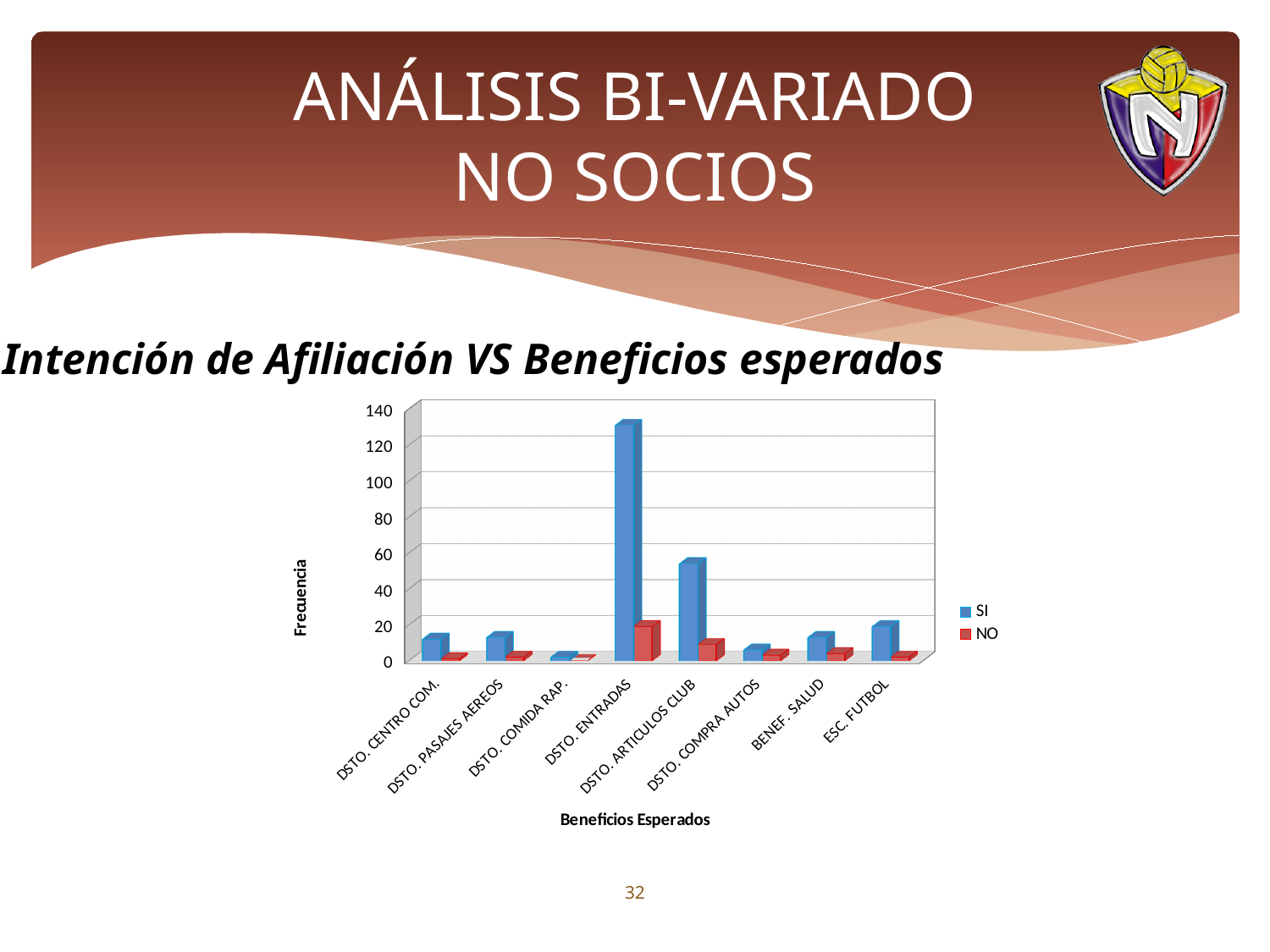
How many series does the chart's legend list? 2 How many categories are shown on the x axis of the chart? 8 Which is larger, the SI value for DSTO. ARTICULOS CLUB or the SI value for ESC. FUTBOL? DSTO. ARTICULOS CLUB Which category has the lowest SI value? DSTO. COMIDA RAP. What is the title of the chart's vertical axis? Frecuencia Which category has the highest NO value? DSTO. ENTRADAS What kind of chart is shown on the slide? bar chart Which category has the highest SI value? DSTO. ENTRADAS Is the SI value for DSTO. ARTICULOS CLUB greater or less than 40? greater What is the title of the chart's horizontal axis? Beneficios Esperados Is the SI value for DSTO. ENTRADAS greater or less than 120? greater